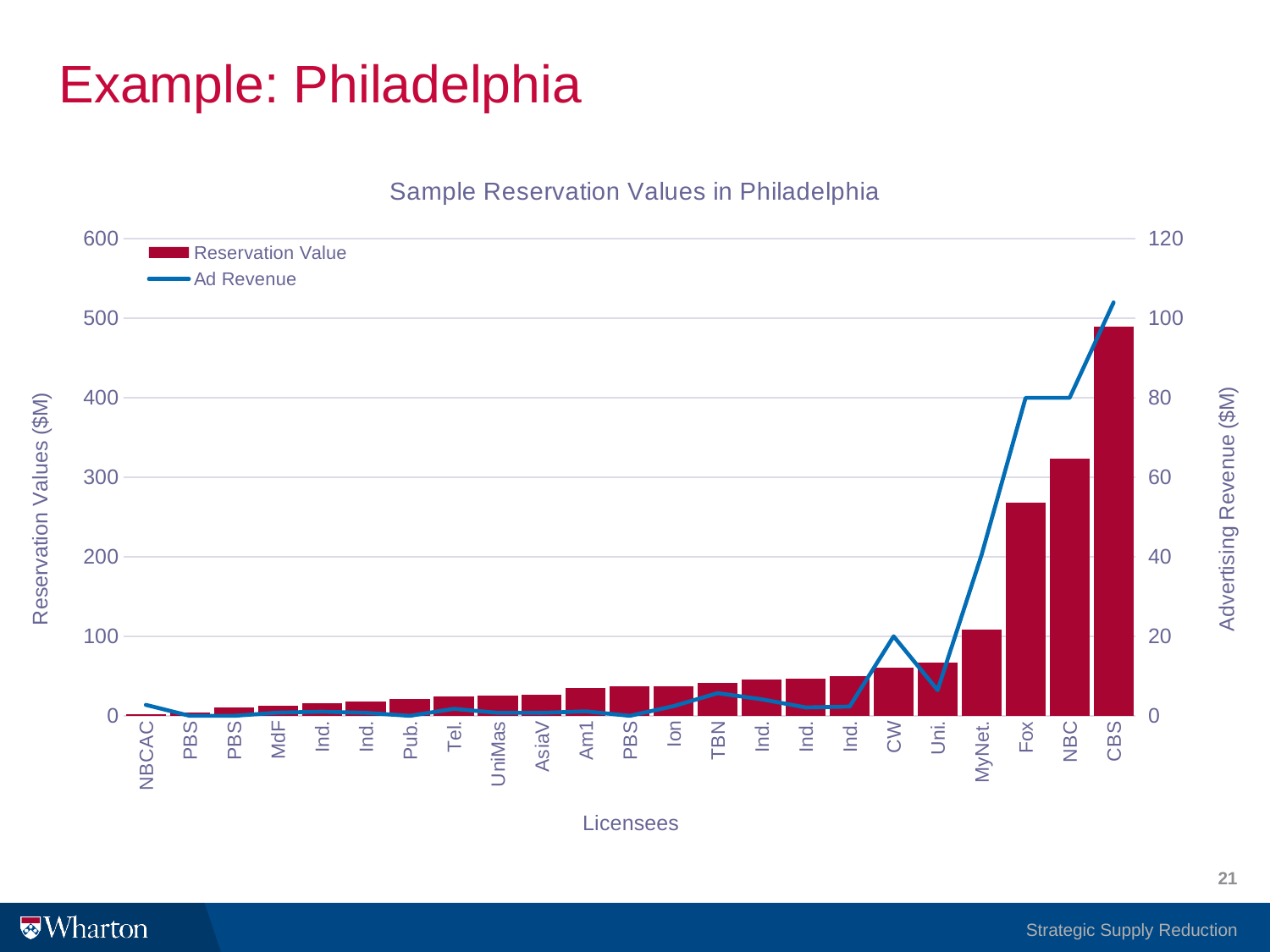
What is the title of the chart? Sample Reservation Values in Philadelphia Which has the larger Reservation Value, NBC or Fox? NBC Is the Ad Revenue for Fox greater or less than 60? greater Is the Reservation Value for Fox greater or less than 300? less Do the Reservation Values generally rise or fall moving from left to right along the x axis? rise Which licensee has the highest Reservation Value? CBS What kind of chart is shown on the slide? A combination bar and line chart Is the Reservation Value for MyNet. greater or less than 200? less How many licensees are plotted along the x axis? 23 How many series does the legend list? 2